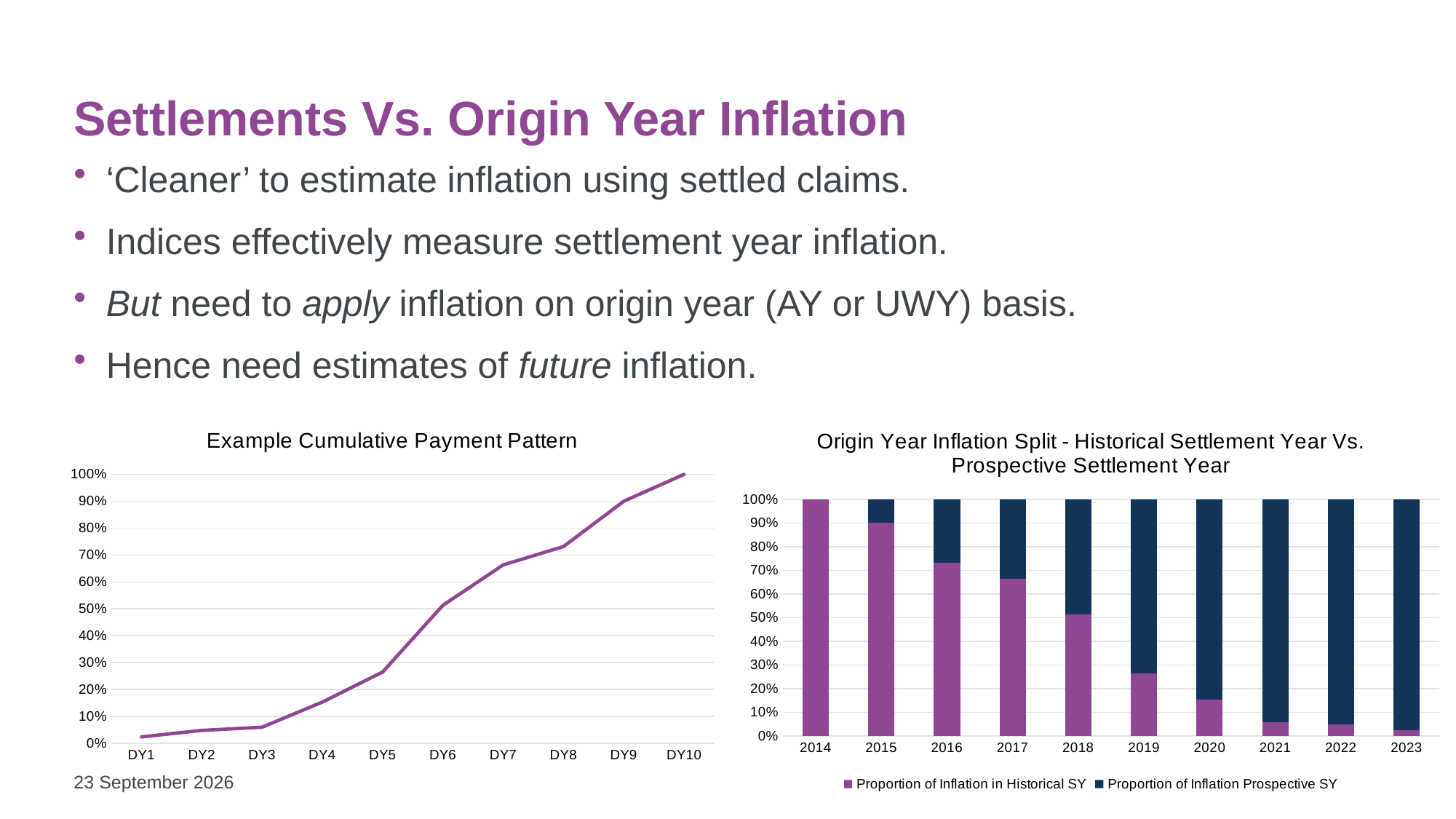
In the 'Origin Year Inflation Split' chart, which year has the highest 'Proportion of Inflation in Historical SY'? 2014 What kind of chart is the 'Origin Year Inflation Split' chart on the right? Bar chart In the 'Origin Year Inflation Split' chart, which year has the lowest 'Proportion of Inflation in Historical SY'? 2023 In the 'Origin Year Inflation Split' chart, which year has a larger 'Proportion of Inflation in Historical SY', 2017 or 2019? 2017 In the 'Example Cumulative Payment Pattern' chart, is the value for DY7 greater or less than 60%? greater In the 'Example Cumulative Payment Pattern' chart, is the value for DY5 greater or less than 30%? less In the 'Example Cumulative Payment Pattern' chart, do the values rise or fall from DY1 to DY10? Rise What kind of chart is the 'Example Cumulative Payment Pattern' chart? Line chart In the 'Example Cumulative Payment Pattern' chart, how many development years (DY) are plotted on the x axis? 10 In the 'Origin Year Inflation Split' chart, is the 'Proportion of Inflation in Historical SY' for 2016 greater or less than 70%? greater In the 'Origin Year Inflation Split' chart, how many years are shown on the x axis? 10 How many series does the legend of the 'Origin Year Inflation Split' chart list? 2